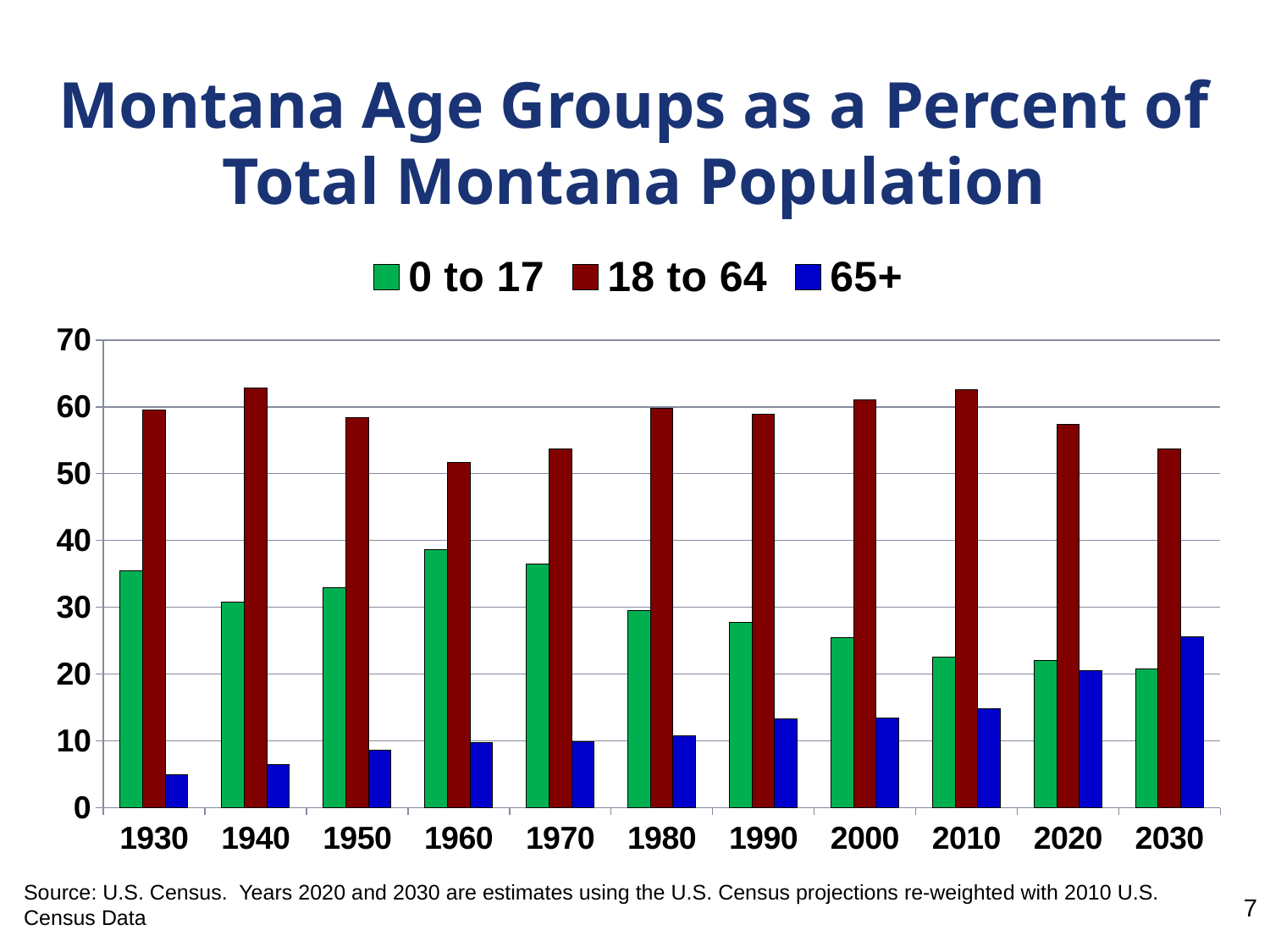
Is the value for 18 to 64 in 1940 greater or less than 60? greater Is the value for 0 to 17 in 2030 greater or less than 30? less In which year is the 18 to 64 share lowest? 1960 In which year is the 0 to 17 share highest? 1960 In which year is the 65+ share highest? 2030 How many series does the legend list? 3 How many years are shown along the x axis? 11 What type of chart is shown on the slide? bar chart Is the value for 65+ in 2030 greater or less than 20? greater In which year is the 65+ share lowest? 1930 Does the 65+ share rise or fall from 1930 to 2030? rise Which is larger in 2030, the 0 to 17 share or the 65+ share? 65+